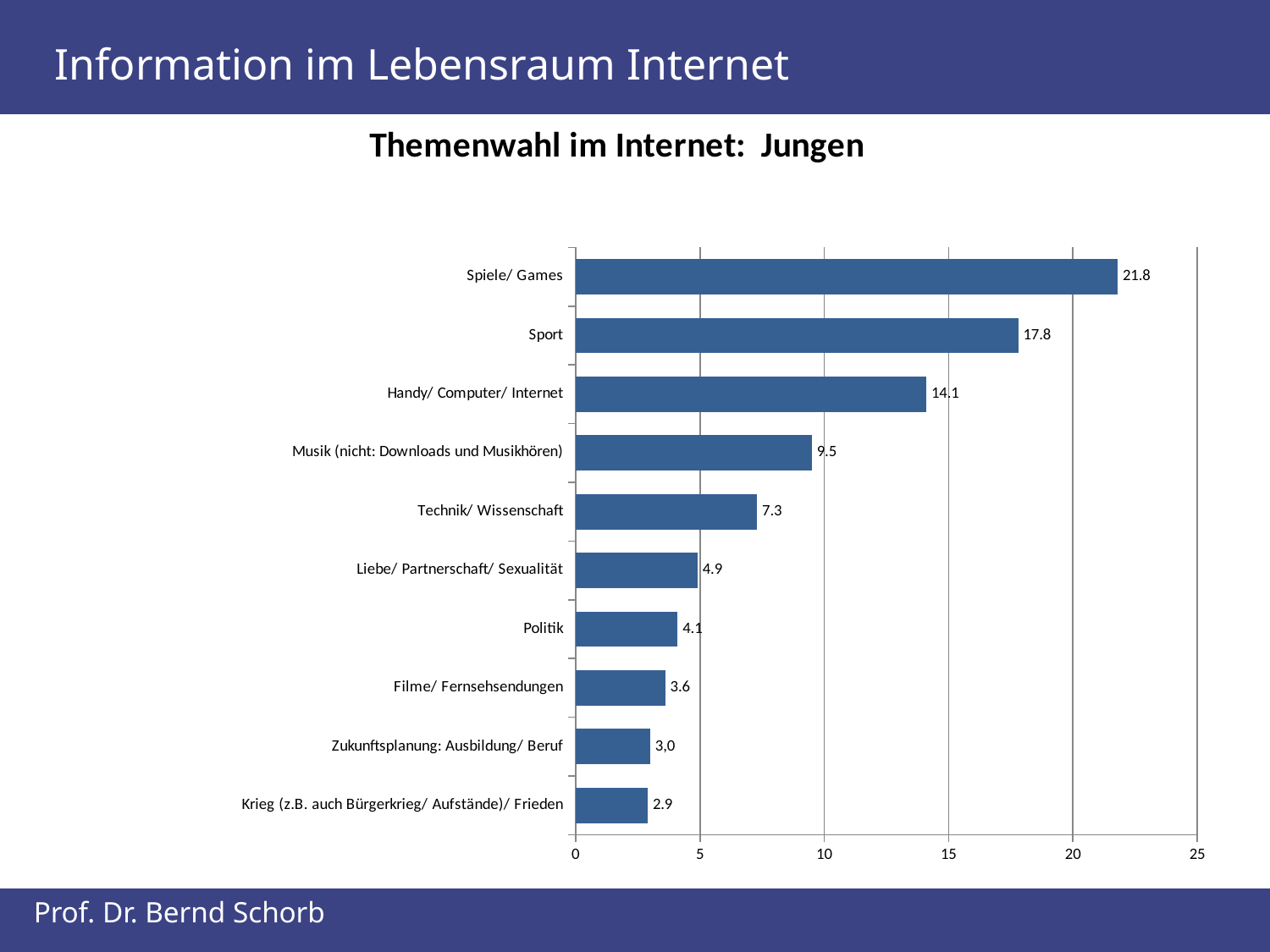
Which category has the lowest value? Krieg (z.B. auch Bürgerkrieg/ Aufstände)/ Frieden Which is larger, the value for Liebe/ Partnerschaft/ Sexualität or the value for Filme/ Fernsehsendungen? Liebe/ Partnerschaft/ Sexualität Which category has the highest value? Spiele/ Games What is the value for Handy/ Computer/ Internet? 14.1 What is the value for Technik/ Wissenschaft? 7.3 How many categories are shown in the chart? 10 What kind of chart is shown on the slide? Bar chart What is the difference between the values for Musik (nicht: Downloads und Musikhören) and Politik? 5.4 Is the value for Sport greater or less than 15? greater What is the value for Zukunftsplanung: Ausbildung/ Beruf? 3,0 What is the difference between the values for Spiele/ Games and Sport? 4.0 What is the value for Spiele/ Games? 21.8